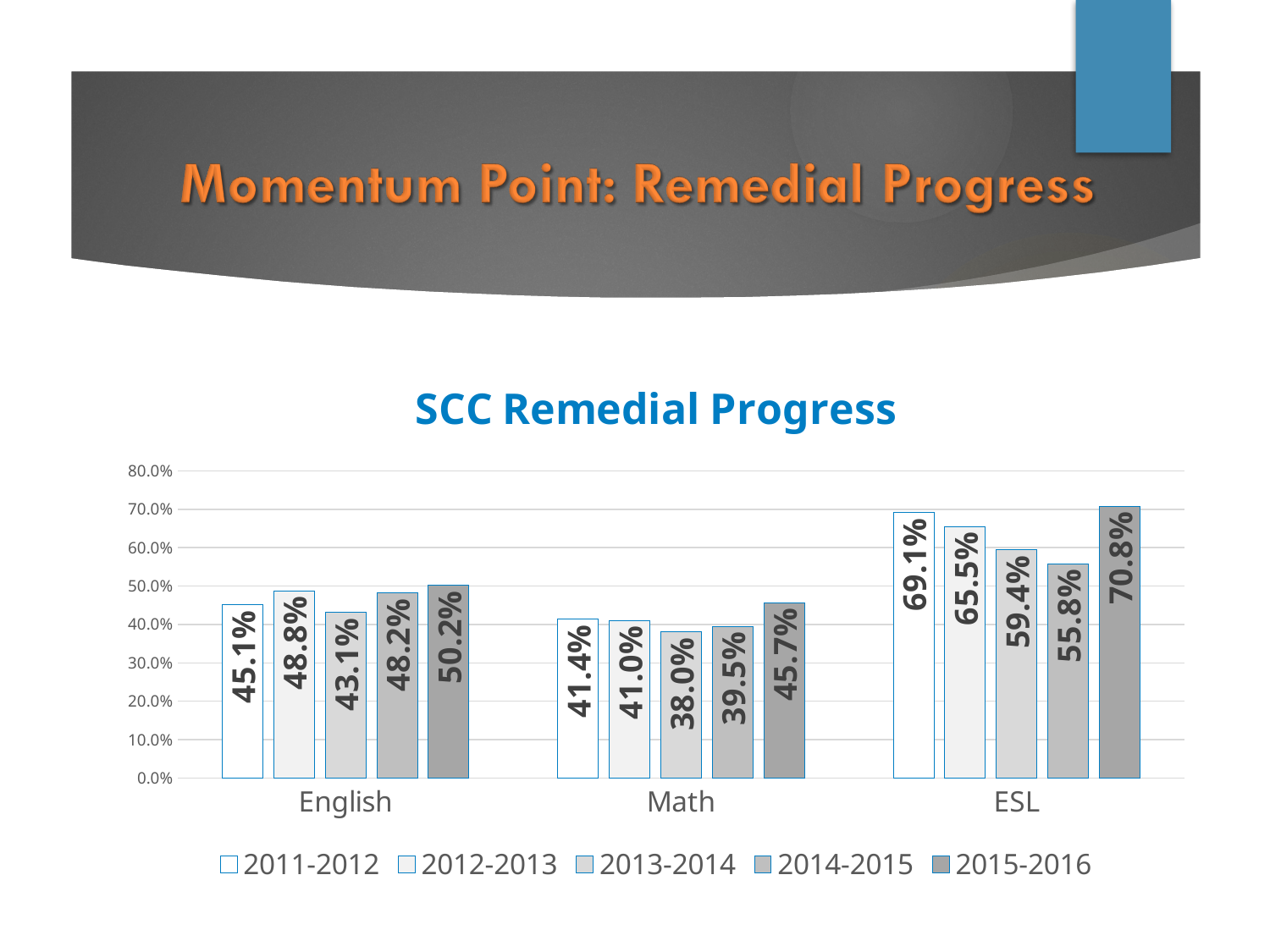
Which category has the highest value in 2015-2016? ESL Is the value for Math in 2015-2016 greater or less than 40.0%? greater What is the difference between the ESL values for 2011-2012 and 2014-2015? 13.3% What is the value for Math in 2013-2014? 38.0% How many series does the legend list? 5 How many categories are shown on the x axis? 3 What is the value for English in 2015-2016? 50.2% What kind of chart is shown? bar chart Which is larger, the English value for 2012-2013 or the English value for 2014-2015? 2012-2013 What is the value for ESL in 2011-2012? 69.1% Which year has the lowest value for Math? 2013-2014 What is the title of the chart? SCC Remedial Progress